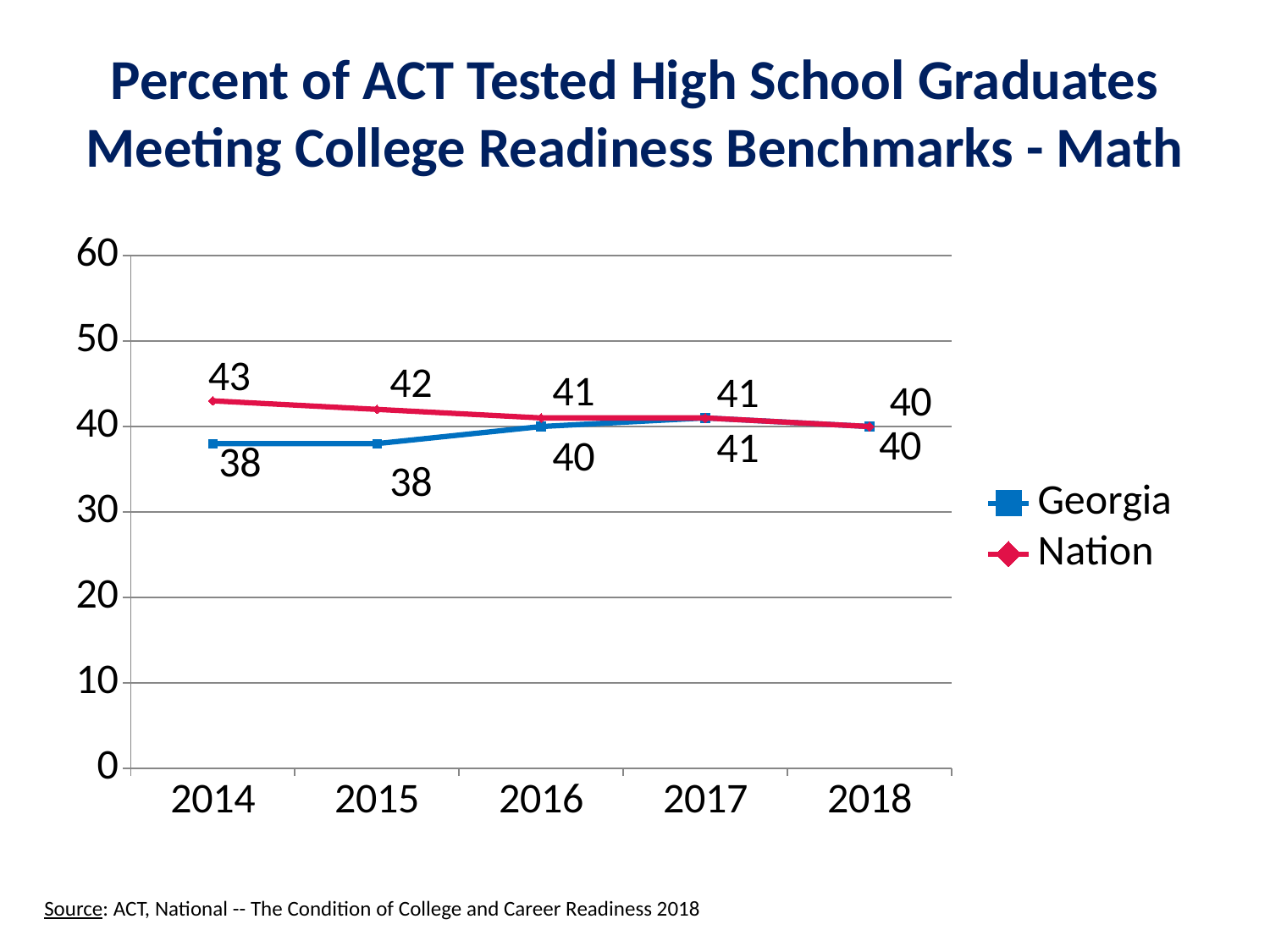
Which is larger in 2015, the Georgia value or the Nation value? Nation What is the difference between the Nation and Georgia values in 2015? 4 How many years are shown on the x axis? 5 What is the value for Georgia in 2016? 40 In which year is the Nation value highest? 2014 What kind of chart is shown? Line chart What is the difference between the Nation and Georgia values in 2014? 5 What is the value for Georgia in 2014? 38 How many series does the legend list? 2 What is the value for Nation in 2018? 40 Does the Nation series rise or fall from 2014 to 2018? Fall What is the value for Nation in 2014? 43